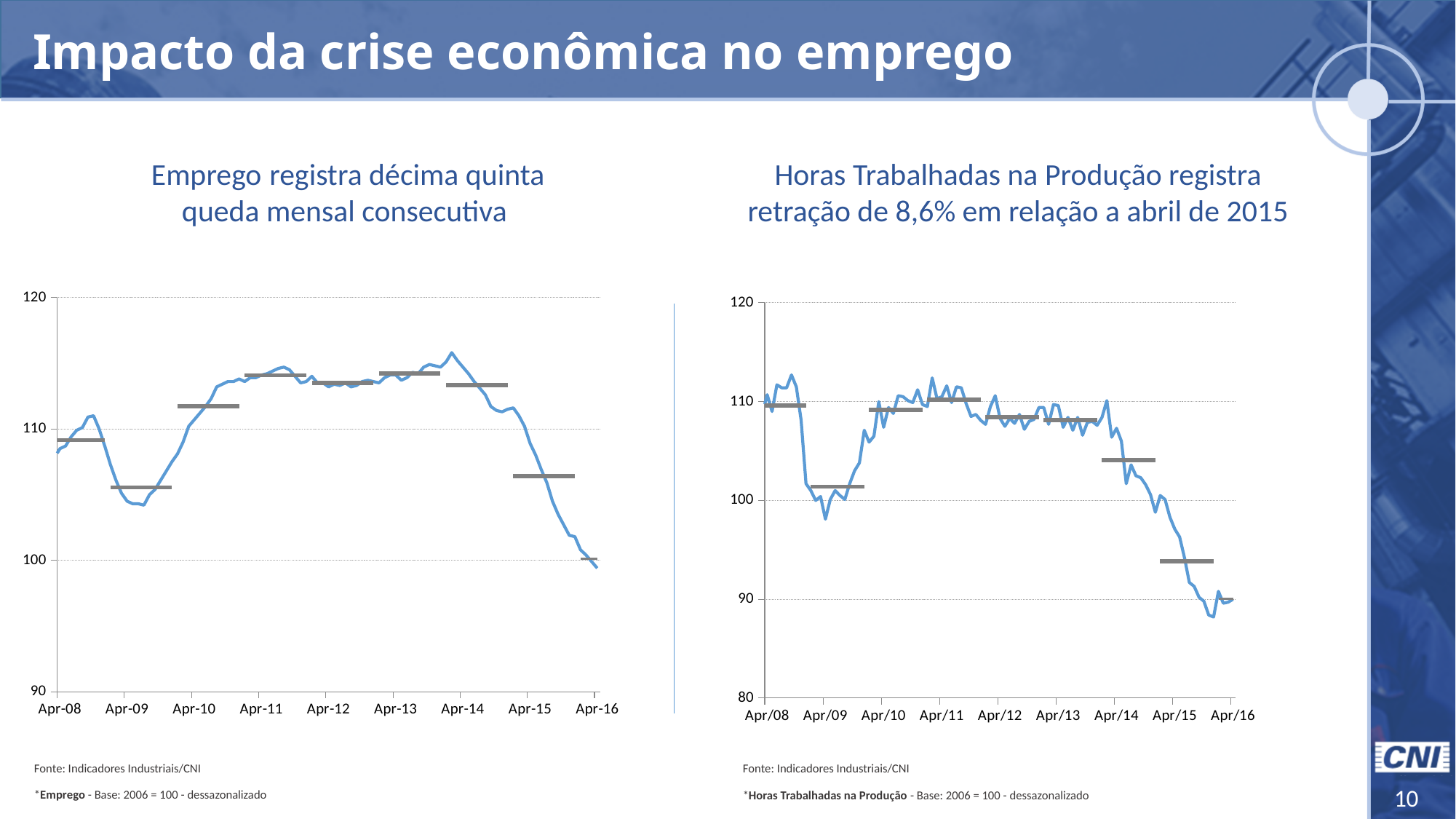
On the left chart (Emprego), is the value at Apr-14 greater or less than 110? greater What is the source cited below the left chart (Emprego)? Indicadores Industriais/CNI What type of chart is the right chart (Horas Trabalhadas na Produção)? line chart On the right chart (Horas Trabalhadas na Produção), how many year labels are shown on the x axis? 9 On the right chart (Horas Trabalhadas na Produção), is the value at Apr/15 greater or less than 100? less On the right chart (Horas Trabalhadas na Produção), which is larger, the value at Apr/08 or the value at Apr/16? Apr/08 On the right chart (Horas Trabalhadas na Produção), does the line rise or fall between Apr/14 and Apr/16? fall On the left chart (Emprego), how many year labels are shown on the x axis? 9 On the right chart (Horas Trabalhadas na Produção), is the value at Apr/14 greater or less than 100? greater What type of chart is the left chart (Emprego)? line chart On the left chart (Emprego), does the line rise or fall between Apr-14 and Apr-16? fall